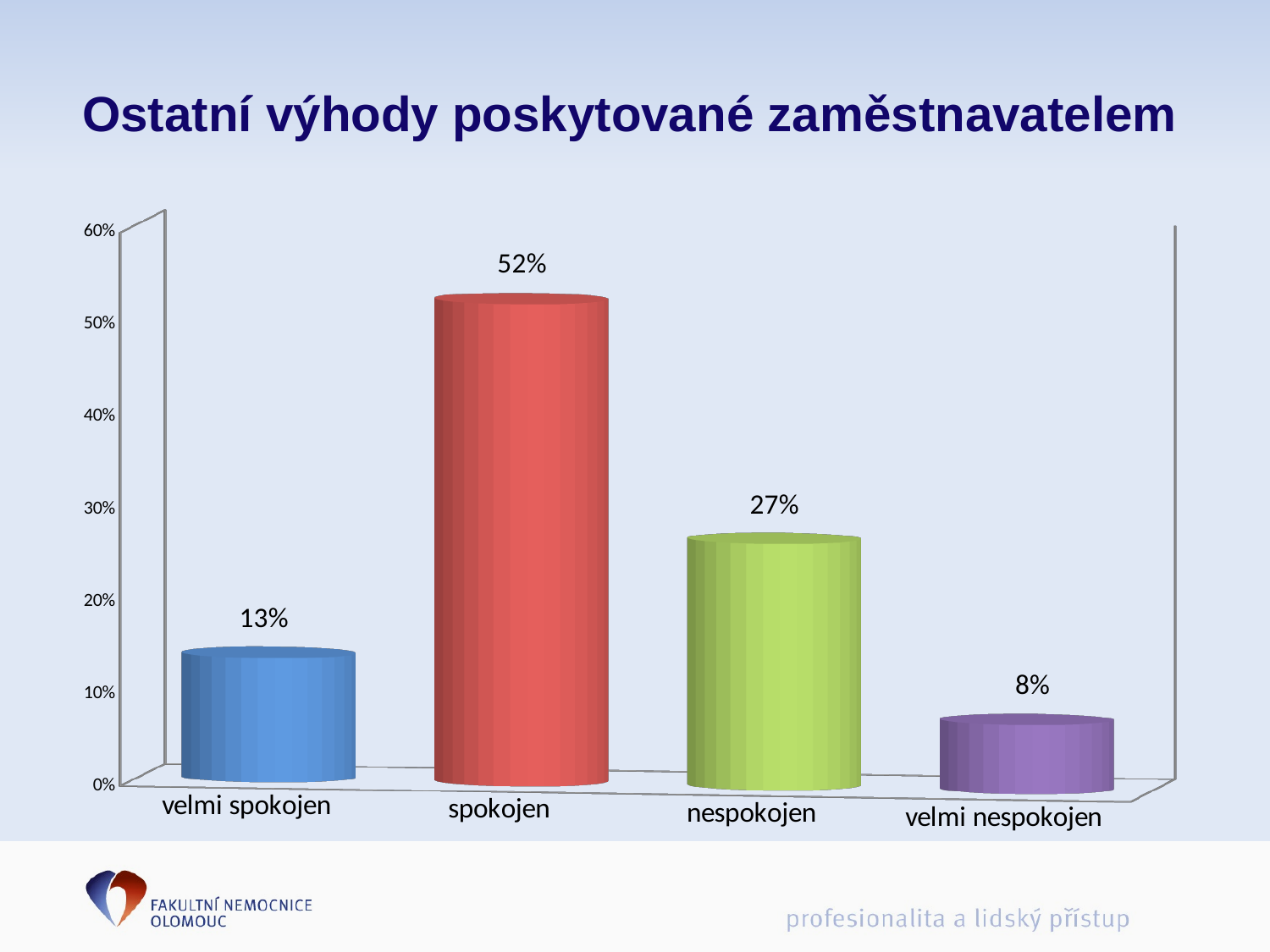
What is the value for "velmi spokojen"? 13% What is the difference between the values for "velmi spokojen" and "velmi nespokojen"? 5% What is the difference between the values for "spokojen" and "nespokojen"? 25% Which category has the lowest value? velmi nespokojen Is the value for "nespokojen" greater or less than 30%? less What is the title of the chart? Ostatní výhody poskytované zaměstnavatelem How many categories are shown on the chart? 4 What is the value for "velmi nespokojen"? 8% Which category has the highest value? spokojen Which is larger, the value for "nespokojen" or the value for "velmi spokojen"? nespokojen What kind of chart is shown on the slide? bar chart What is the value for "spokojen"? 52%